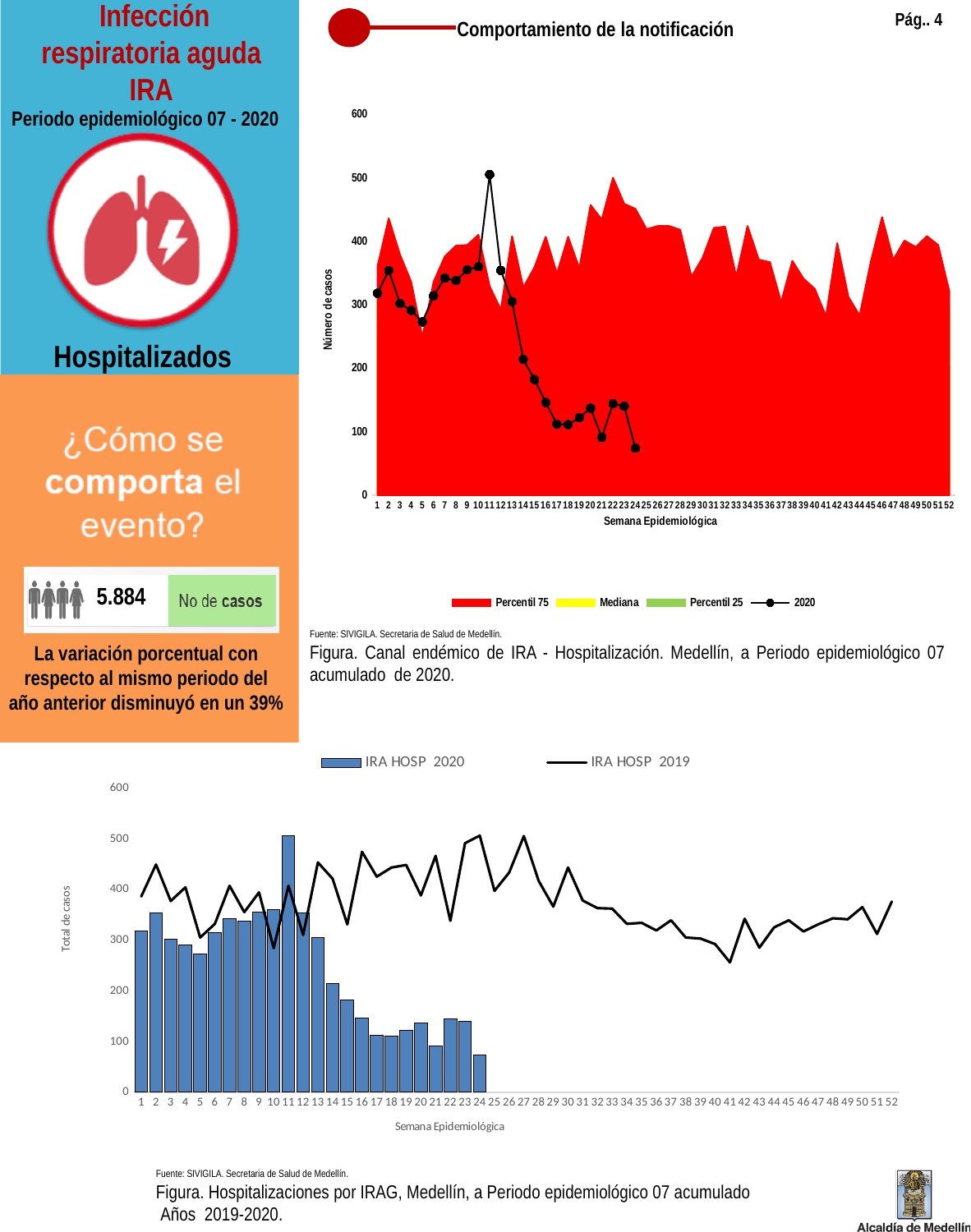
How many series does the legend of the bottom chart list? 2 How many series does the legend of the top chart (Canal endémico de IRA) list? 4 In the bottom chart, how many epidemiological weeks have an IRA HOSP 2020 bar? 24 In the bottom chart, is the IRA HOSP 2020 value for week 15 greater or less than 200? less In the bottom chart, do the IRA HOSP 2020 bars rise or fall from week 11 to week 24? fall In the bottom chart, which epidemiological week has the highest IRA HOSP 2020 bar? 11 In the top chart, which series is shown in red? Percentil 75 In the bottom chart, is the IRA HOSP 2020 value for week 11 greater or less than 400? greater What kind of chart is the bottom chart (Hospitalizaciones por IRAG, 2019-2020)? bar chart with a line In the bottom chart, which epidemiological week has the lowest IRA HOSP 2020 bar? 24 In the top chart, is the 2020 value for week 11 greater or less than 400? greater